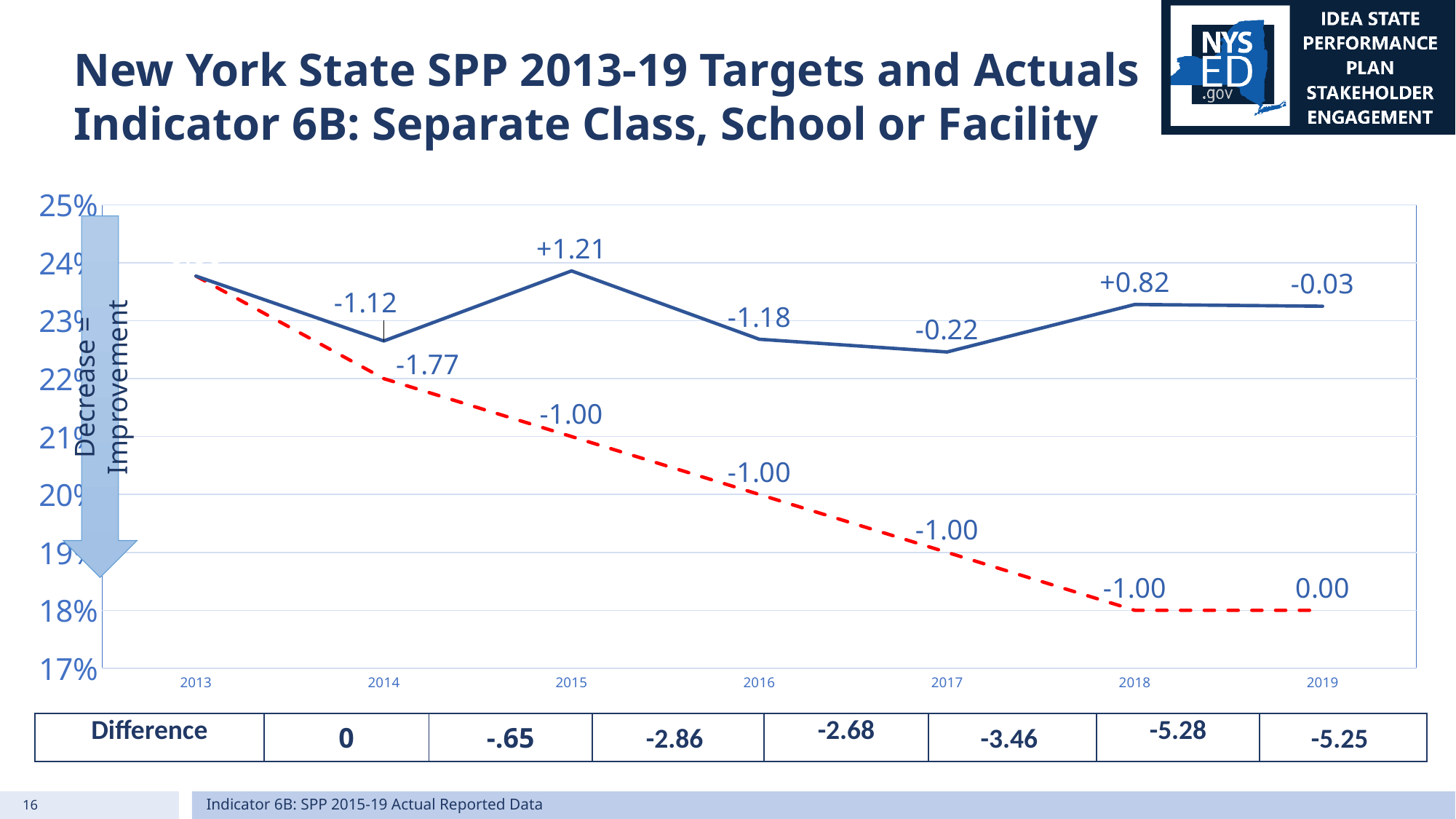
What is the data label shown on the red dashed line at 2014? -1.77 What kind of chart is shown on the slide? line chart How many years are plotted along the x axis of the chart? 7 What value does the red dashed line reach in 2019? 18% What is the data label shown on the red dashed line at 2019? 0.00 What is the data label shown on the solid blue line at 2018? +0.82 What is the data label shown on the solid blue line at 2014? -1.12 In 2019, which line is higher on the chart, the solid blue line or the red dashed line? the solid blue line What is the data label shown on the solid blue line at 2015? +1.21 Does the red dashed line rise or fall from 2013 to 2018? fall Is the value of the solid blue line in 2013 greater or less than 23%? greater Is the value of the red dashed line in 2017 greater or less than 20%? less